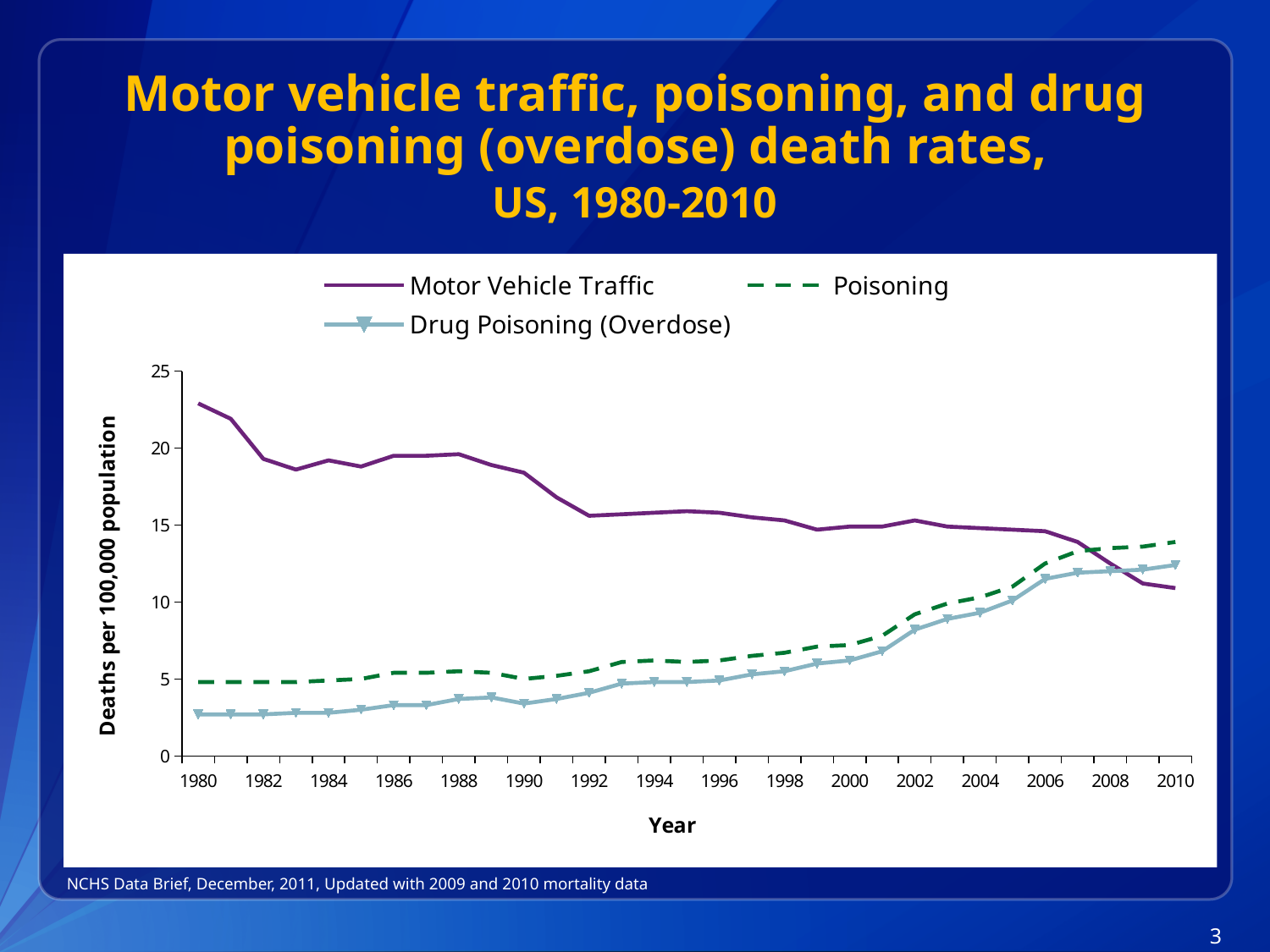
In 1990, which series has the higher value, Motor Vehicle Traffic or Poisoning? Motor Vehicle Traffic Is the Poisoning value in 2010 greater or less than 10? greater What kind of chart is shown on the slide? line chart Is the Drug Poisoning (Overdose) value in 1980 greater or less than 5? less Does the Motor Vehicle Traffic death rate rise or fall from 1980 to 2010? fall Which series has the highest value in 1980? Motor Vehicle Traffic Is the Motor Vehicle Traffic value in 2010 greater or less than 15? less How many series does the legend list? 3 What is the label on the vertical axis of the chart? Deaths per 100,000 population Does the Drug Poisoning (Overdose) death rate rise or fall from 1980 to 2010? rise In 2010, which series has the higher value, Poisoning or Motor Vehicle Traffic? Poisoning